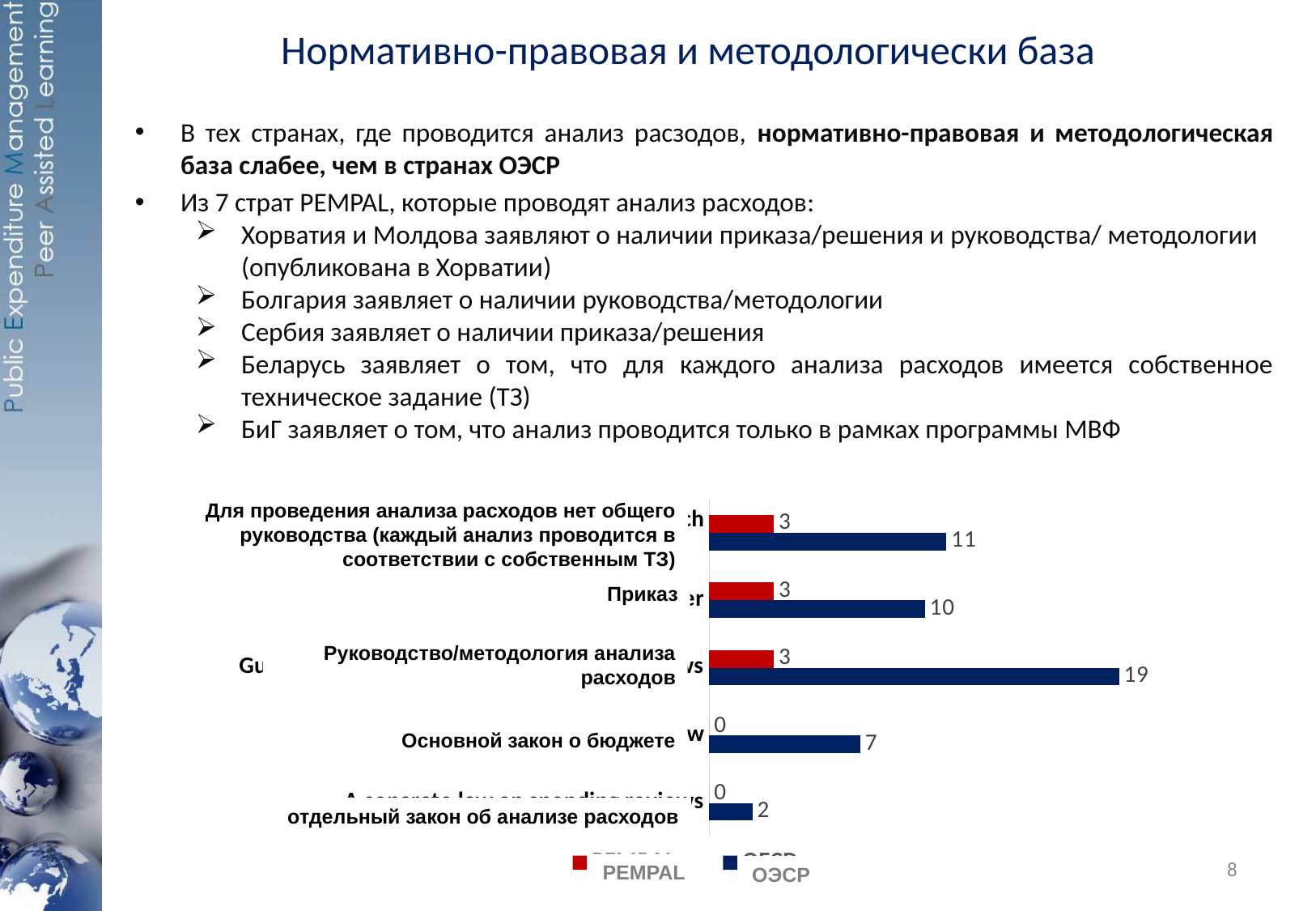
What is the ОЭСР value for "Основной закон о бюджете"? 7 Which category has the highest ОЭСР value? Руководство/методология анализа расходов What is the difference between the ОЭСР and PEMPAL values for "Руководство/методология анализа расходов"? 16 What is the PEMPAL value for "отдельный закон об анализе расходов"? 0 How many series does the legend list? 2 Which category has the lowest ОЭСР value? отдельный закон об анализе расходов What is the PEMPAL value for "Приказ"? 3 For "Приказ", which series has the larger value, PEMPAL or ОЭСР? ОЭСР Which colour represents the ОЭСР series in the chart? Dark blue What kind of chart is shown on the slide? Bar chart What is the ОЭСР value for "Руководство/методология анализа расходов"? 19 How many categories are shown in the chart? 5